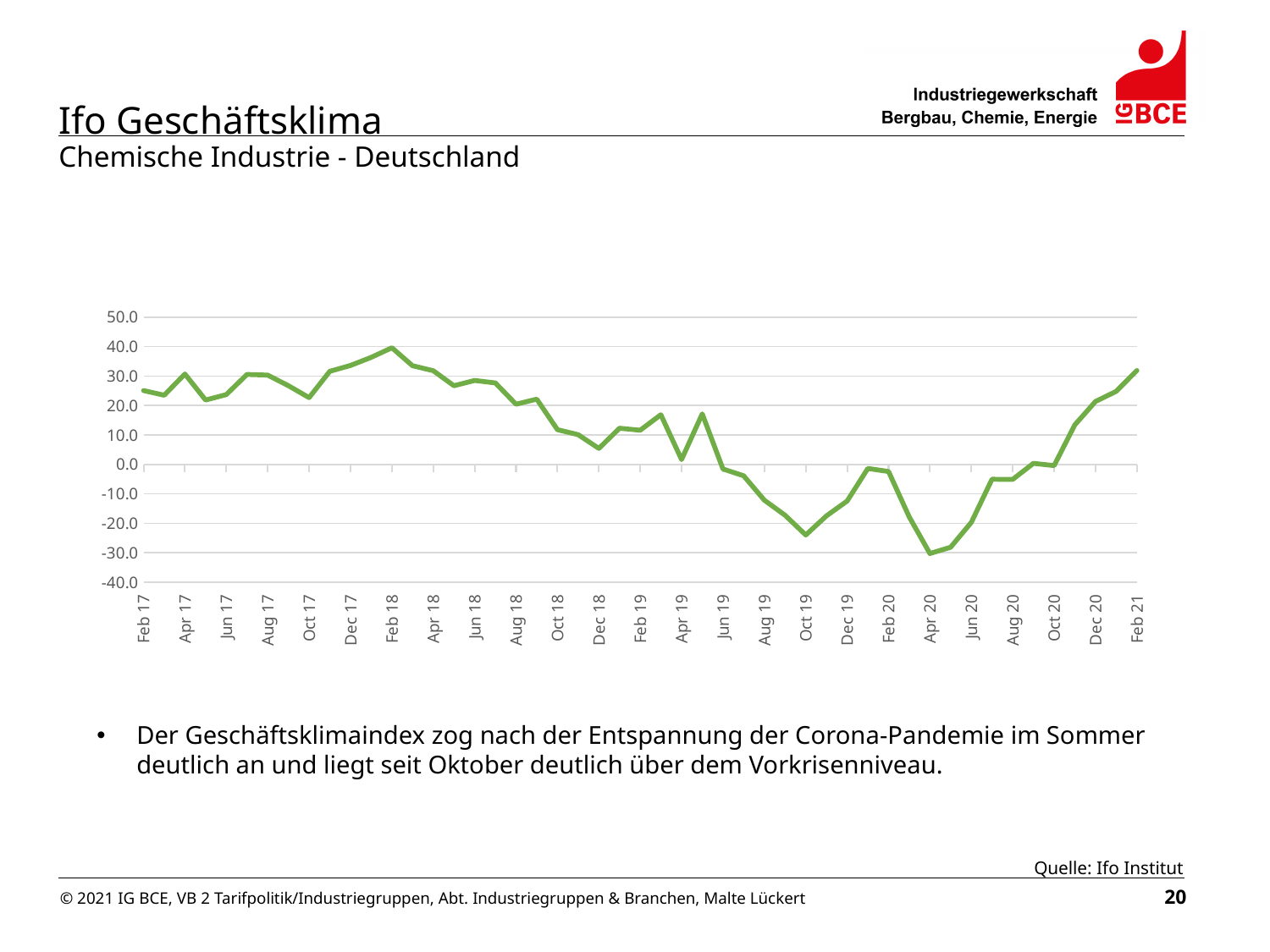
Is the value for Oct 19 greater or less than -10? less What is the source given for the chart data? Ifo Institut Is the value for Feb 17 greater or less than 20? greater Which x-axis label corresponds to the lowest point of the line? Apr 20 What kind of chart is shown on the slide? line chart Which x-axis label corresponds to the highest point of the line? Feb 18 Does the line rise or fall between Apr 20 and Feb 21? rise Is the value for Feb 18 greater or less than 30? greater Which is larger, the value for Feb 18 or the value for Apr 20? Feb 18 How many labels are shown on the x axis? 25